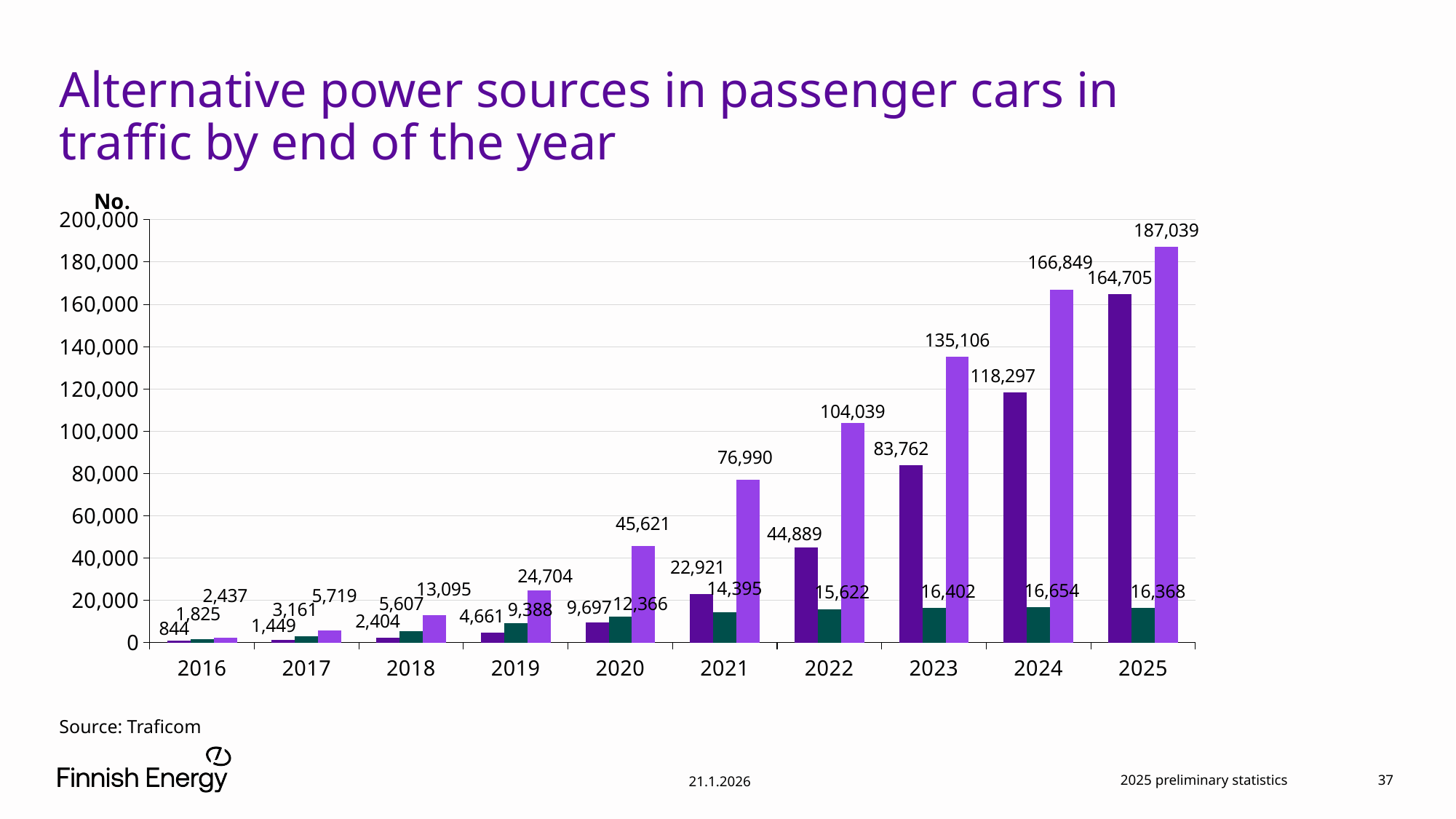
How many years are shown on the x axis? 10 Is the value of the dark purple bar for 2024 greater or less than 100,000? greater What is the value of the light purple bar for 2025? 187,039 What kind of chart is shown on the slide? bar chart In 2020, which is larger: the dark purple bar or the teal bar? the teal bar In which year is the dark purple bar lowest? 2016 What is the value of the teal bar for 2023? 16,402 What is the difference between the light purple bar in 2024 and the light purple bar in 2023? 31,743 In which year is the light purple bar highest? 2025 What is the value of the dark purple bar for 2021? 22,921 What is the difference between the light purple bar and the dark purple bar in 2025? 22,334 What is the value of the light purple bar for 2019? 24,704